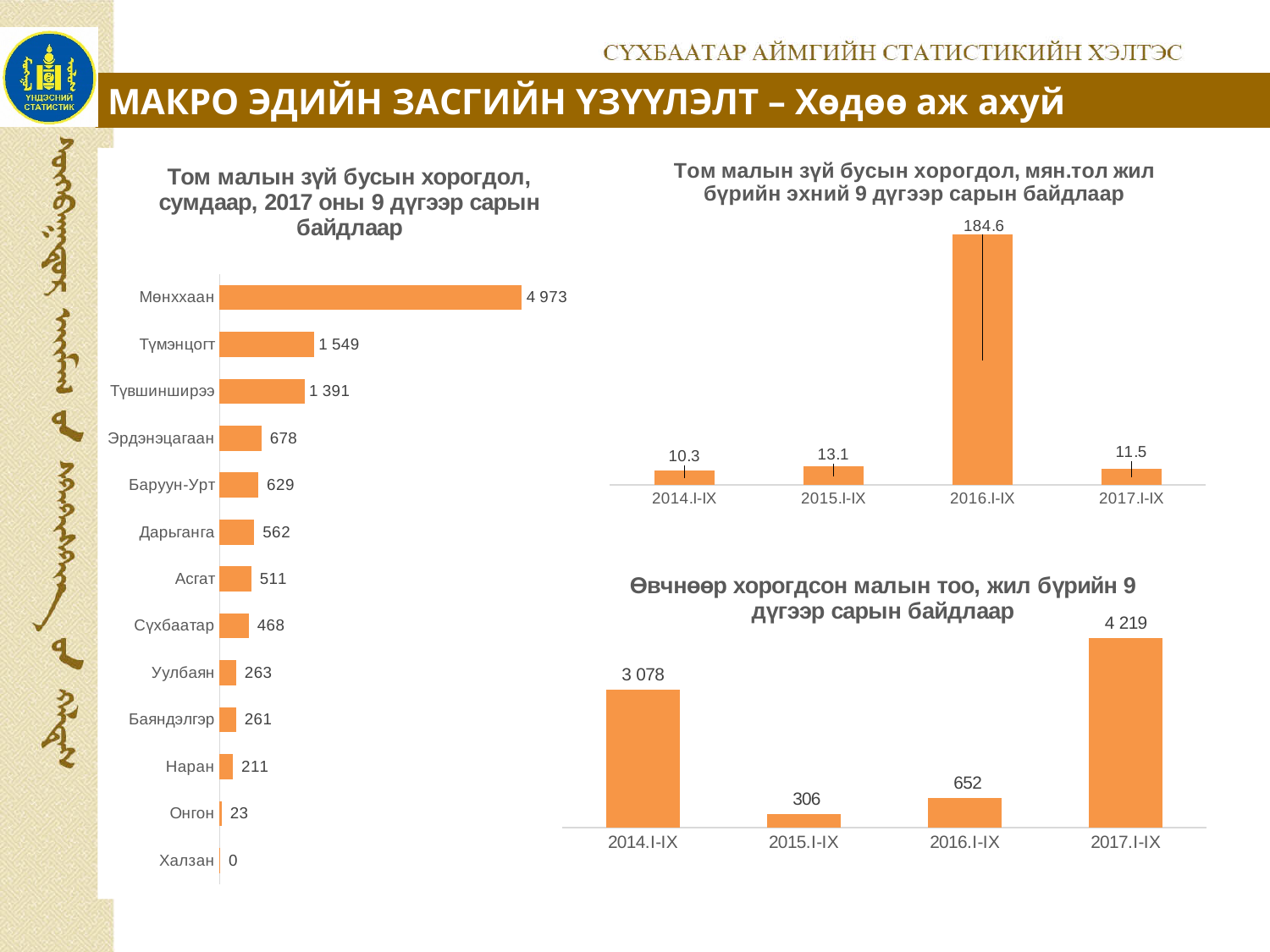
In the bottom-right chart (Өвчнөөр хорогдсон малын тоо), what is the difference between 2017.I-IX and 2014.I-IX? 1 141 In the left chart (Том малын зүй бусын хорогдол, сумдаар), how many sums are listed? 13 In the top-right chart (Том малын зүй бусын хорогдол, мян.тол), which period has the highest value? 2016.I-IX In the left chart (Том малын зүй бусын хорогдол, сумдаар), which sum has the lowest value? Халзан In the top-right chart (Том малын зүй бусын хорогдол, мян.тол), what is the value for 2016.I-IX? 184.6 In the left chart (Том малын зүй бусын хорогдол, сумдаар), which is larger, Дарьганга or Асгат? Дарьганга In the bottom-right chart (Өвчнөөр хорогдсон малын тоо), what is the value for 2017.I-IX? 4 219 In the left chart (Том малын зүй бусын хорогдол, сумдаар), what is the value for Мөнххаан? 4 973 In the top-right chart (Том малын зүй бусын хорогдол, мян.тол), what is the difference between 2015.I-IX and 2014.I-IX? 2.8 In the left chart (Том малын зүй бусын хорогдол, сумдаар), what is the difference between Түмэнцогт and Түвшинширээ? 158 What kind of chart is the left chart (Том малын зүй бусын хорогдол, сумдаар)? Bar chart In the bottom-right chart (Өвчнөөр хорогдсон малын тоо), which period has the lowest value? 2015.I-IX